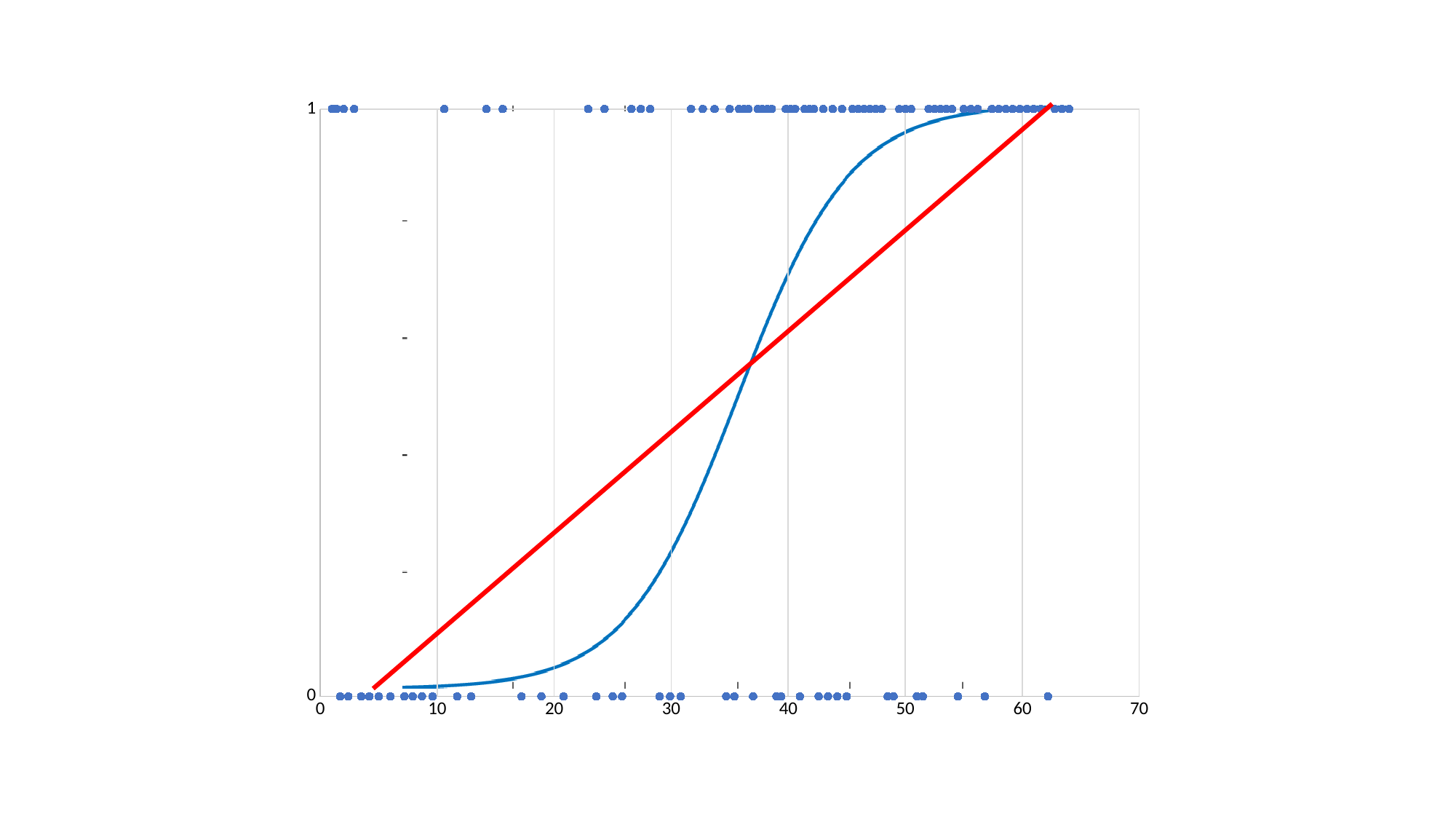
Does the blue S-shaped curve rise or fall as the x-axis value increases? rise What colour is the straight line on the chart? red At x = 50, which is higher, the red straight line or the blue S-shaped curve? the blue S-shaped curve At x = 30, which is higher, the red straight line or the blue S-shaped curve? the red straight line What kind of chart is shown on the slide? scatter chart Does the red straight line rise or fall as the x-axis value increases? rise At x = 20, which is higher, the red straight line or the blue S-shaped curve? the red straight line What is the largest value labelled on the x axis? 70